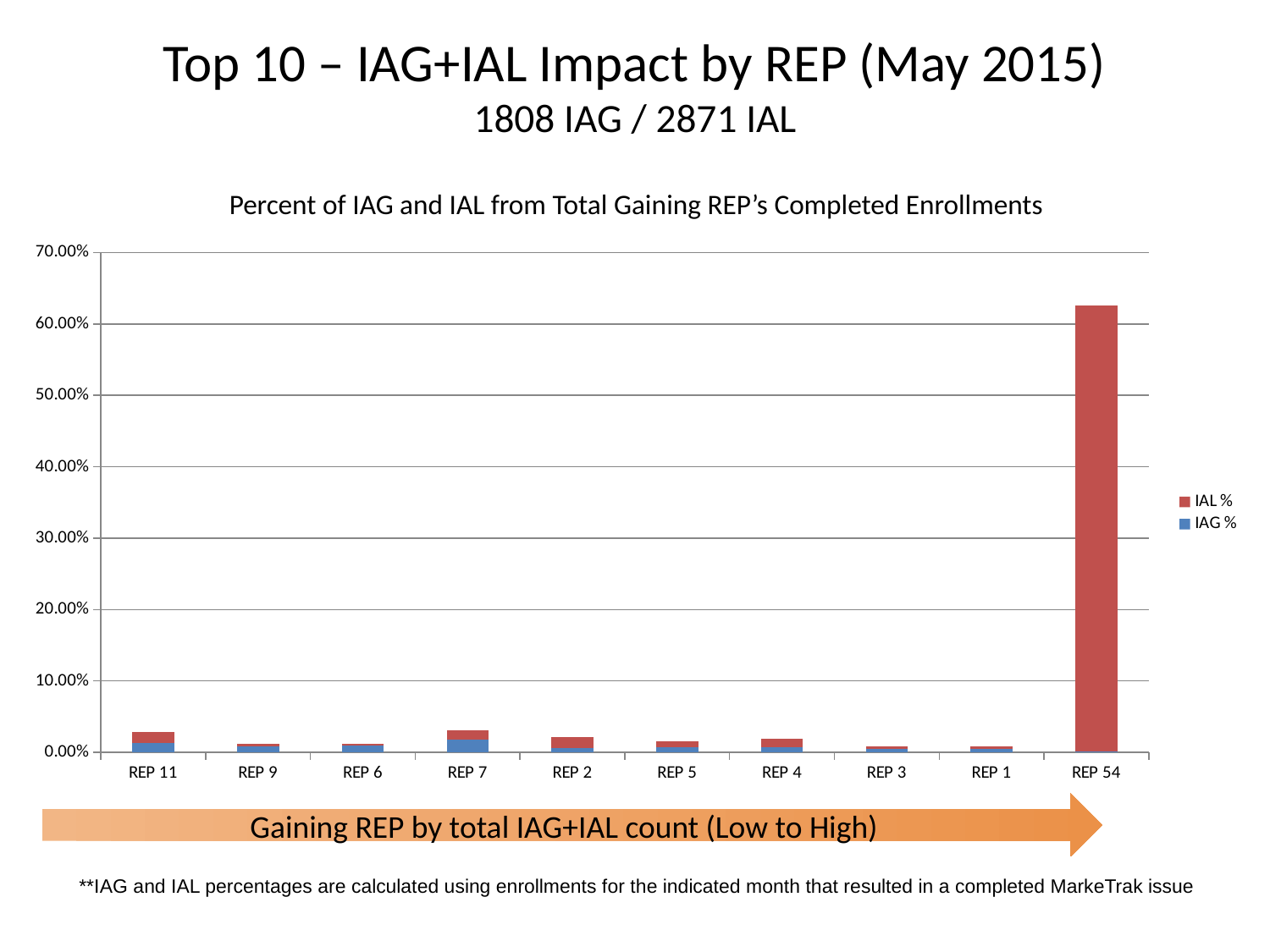
How many REP categories are plotted along the x axis? 10 Which has the larger total stacked bar, REP 7 or REP 3? REP 7 Is the total value for REP 7 greater or less than 10.00%? less How many series does the legend list? 2 Which REP has the highest total stacked bar? REP 54 Which REP category is the last one on the x axis? REP 54 Which has the larger total stacked bar, REP 54 or REP 11? REP 54 Is the total value for REP 54 greater or less than 50.00%? greater Is the total value for REP 11 greater or less than 10.00%? less Which series is shown in red in the legend? IAL % What kind of chart is shown on the slide? Stacked bar chart What is the title of the chart? Percent of IAG and IAL from Total Gaining REP's Completed Enrollments